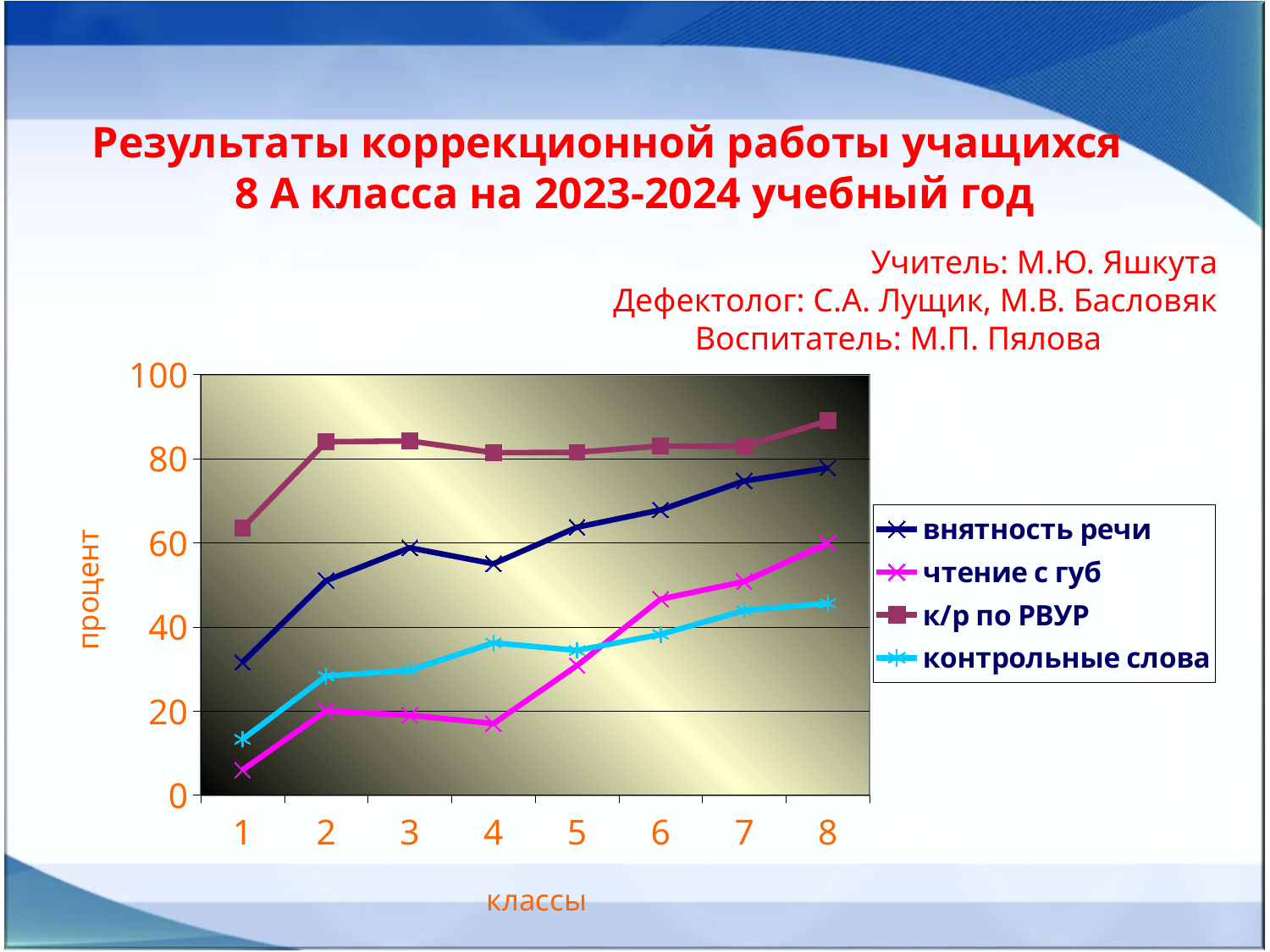
Which series has the lowest value at class 1? чтение с губ How many series does the legend list? 4 Is the value for контрольные слова at class 8 greater or less than 40? greater Is the value for внятность речи at class 8 greater or less than 60? greater How many classes (points) are plotted along the x axis? 8 What kind of chart is shown on the slide? line chart Is the value for чтение с губ at class 1 greater or less than 20? less At class 4, which is larger: внятность речи or контрольные слова? внятность речи What is the title of the vertical axis? процент Which series has the highest value at class 8? к/р по РВУР Does the чтение с губ series rise or fall from class 5 to class 8? rise